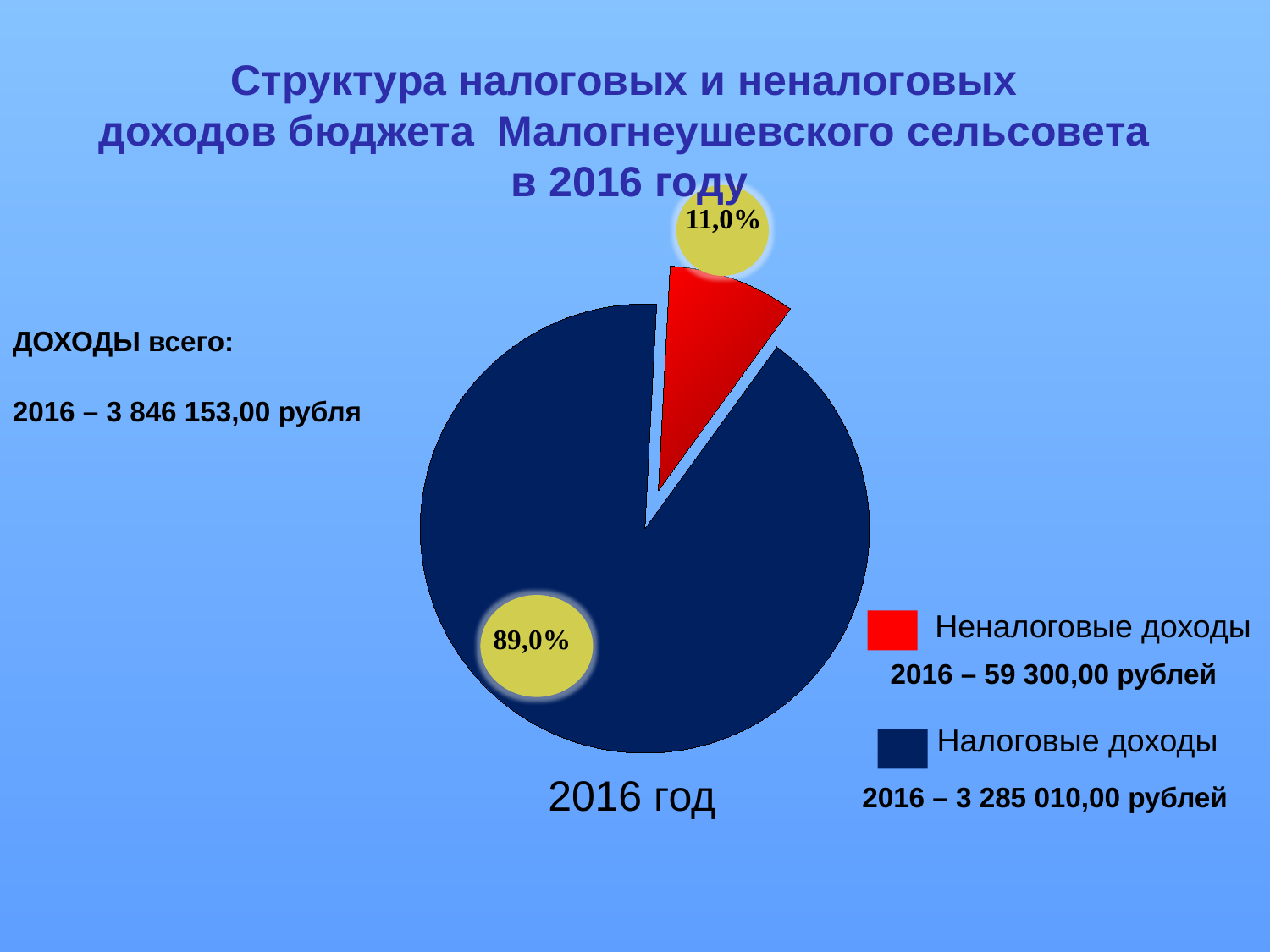
Which is larger in the pie chart: Налоговые доходы or Неналоговые доходы? Налоговые доходы How many entries does the legend list? 2 What is the difference in percentage points between the Налоговые доходы slice and the Неналоговые доходы slice? 78,0% What kind of chart is shown on the slide? Pie chart What share of the pie chart does Неналоговые доходы represent? 11,0% Which category has the largest slice in the pie chart? Налоговые доходы How many slices does the pie chart have? 2 Which category has the smallest slice in the pie chart? Неналоговые доходы What amount in rubles is given for Налоговые доходы in 2016? 3 285 010,00 рублей What share of the pie chart does Налоговые доходы represent? 89,0% What colour is the Неналоговые доходы slice in the pie chart? Red What amount in rubles is given for Неналоговые доходы in 2016? 59 300,00 рублей